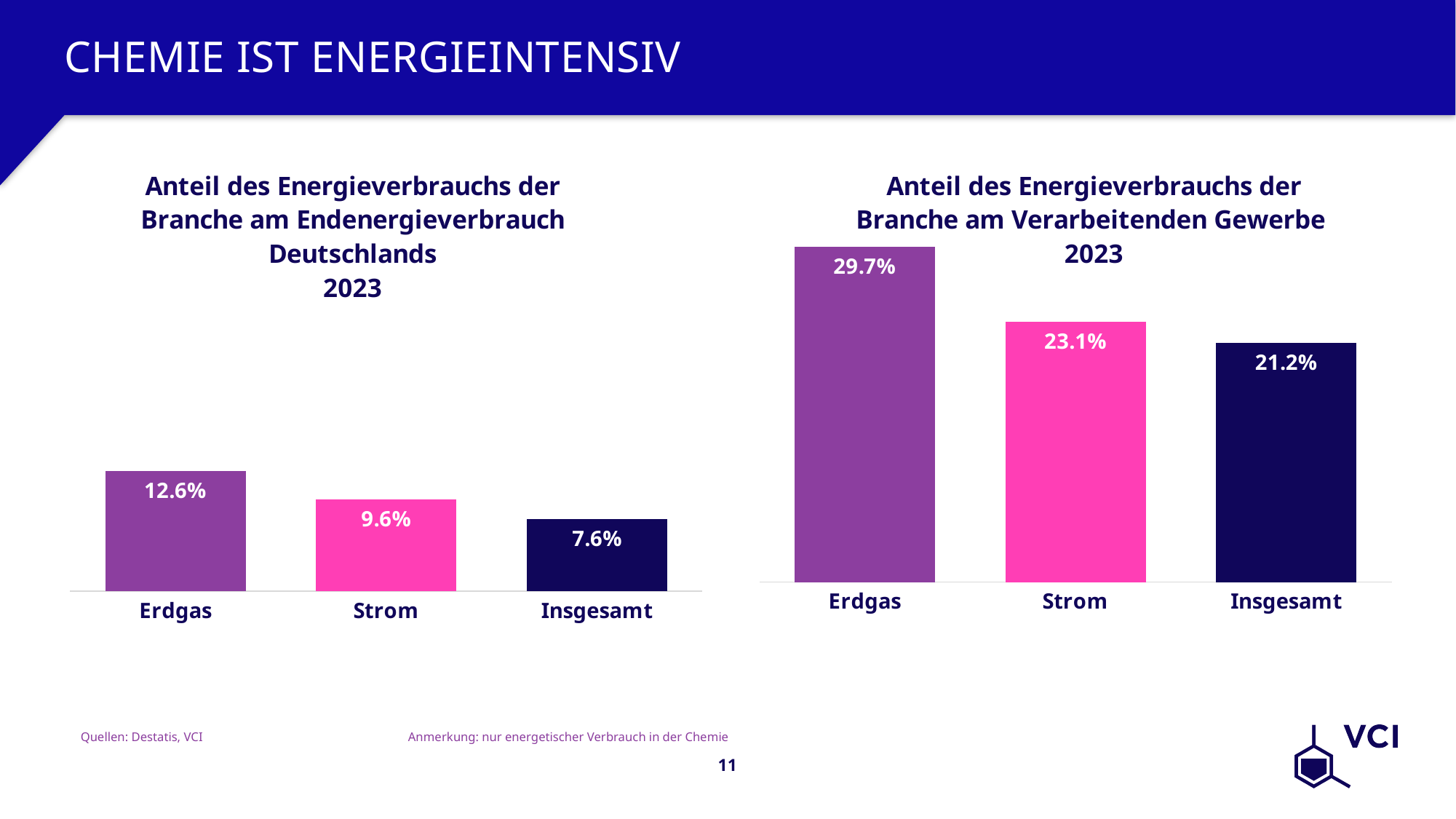
Which is larger: the value for Strom in the left chart or the value for Insgesamt in the right chart? Insgesamt in the right chart How many categories does the left chart (Endenergieverbrauch Deutschlands) show? 3 In the left chart (Anteil des Energieverbrauchs der Branche am Endenergieverbrauch Deutschlands 2023), what is the value for Erdgas? 12.6% What kind of chart is the right chart (Verarbeitendes Gewerbe)? Bar chart In the right chart (Verarbeitendes Gewerbe), what is the difference between the values for Erdgas and Strom? 6.6% In the right chart (Verarbeitendes Gewerbe), what is the value for Strom? 23.1% In the right chart (Verarbeitendes Gewerbe), which category has the lowest value? Insgesamt In the left chart (Endenergieverbrauch Deutschlands), which category has the highest value? Erdgas In the left chart (Endenergieverbrauch Deutschlands), what is the value for Strom? 9.6% In the left chart (Endenergieverbrauch Deutschlands), what is the difference between the values for Erdgas and Insgesamt? 5.0% In the right chart (Anteil des Energieverbrauchs der Branche am Verarbeitenden Gewerbe 2023), what is the value for Insgesamt? 21.2% In the right chart (Verarbeitendes Gewerbe), do the values rise or fall from Erdgas to Insgesamt? Fall